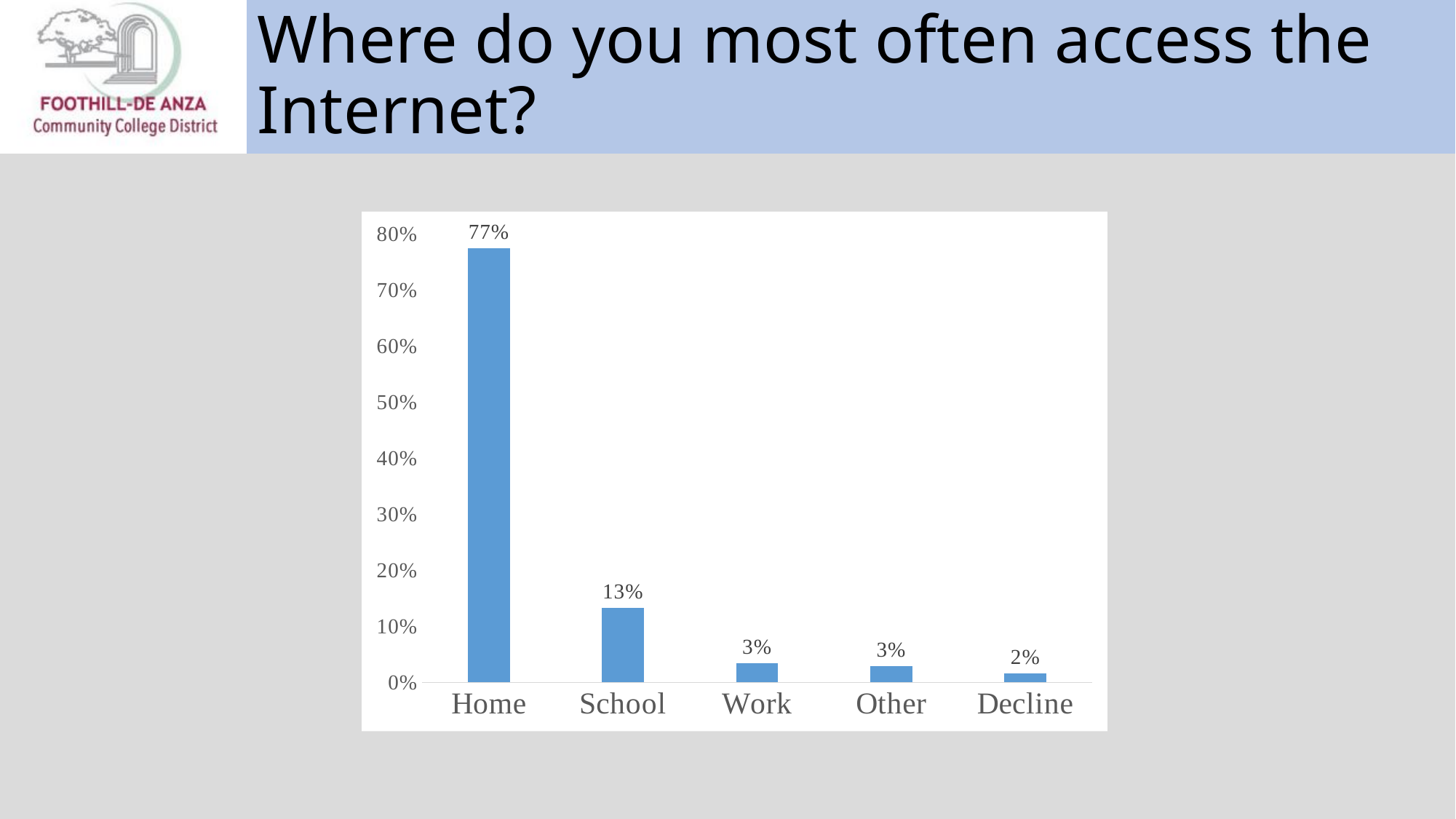
What is the difference between the values for School and Work? 10% Which category has the lowest value? Decline What percentage of respondents most often access the Internet at Home? 77% Which category has the highest value? Home What is the value shown for School? 13% What is the title of the slide containing the chart? Where do you most often access the Internet? Which is larger, the value for School or the value for Other? School What is the difference between the values for Home and School? 64% Is the value for Home greater or less than 70%? greater How many categories are shown on the x axis? 5 What kind of chart is shown on the slide? Bar chart What is the value shown for Decline? 2%